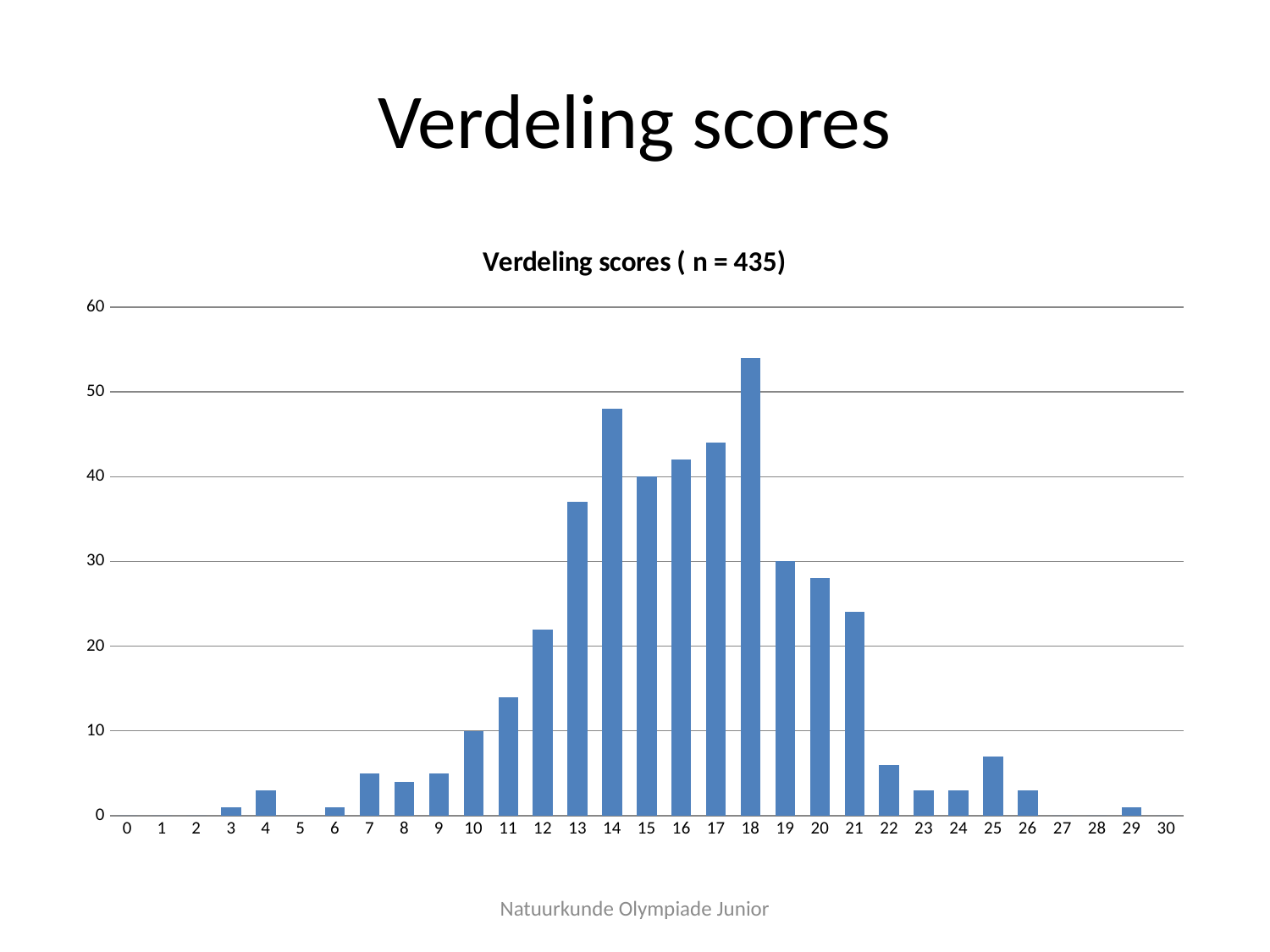
Is the value for score 13 greater or less than 40? less What is the title of the chart? Verdeling scores ( n = 435) Which score has the tallest bar? 18 Is the value for score 21 greater or less than 20? greater Is the value for score 14 greater or less than 40? greater How many score categories are shown on the x axis? 31 Which has the larger value, score 13 or score 20? score 13 What type of chart is shown on the slide? bar chart Which has the larger value, score 11 or score 22? score 11 Do the values rise or fall from score 18 to score 21? fall